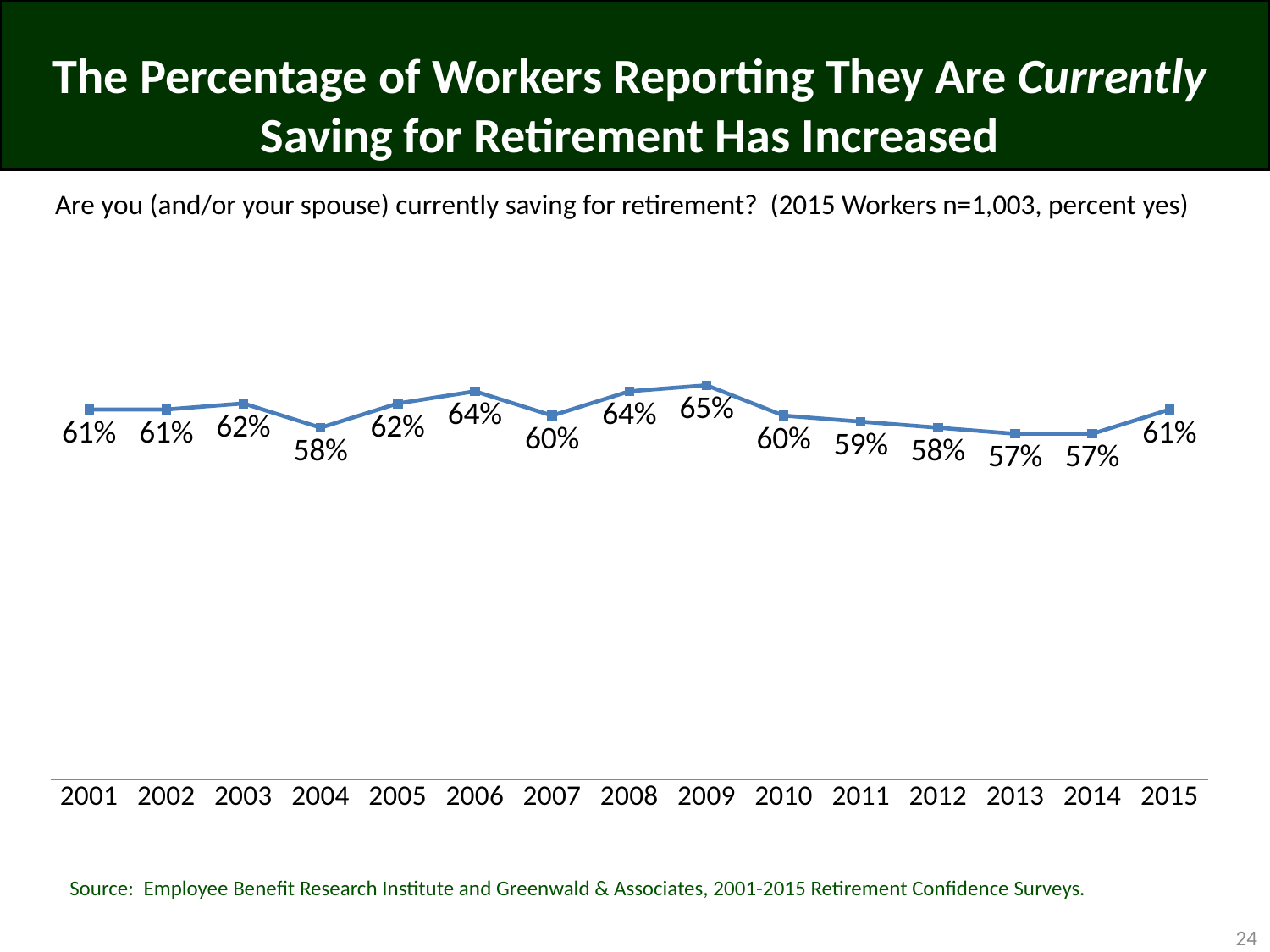
Which year has the highest percentage of workers currently saving for retirement? 2009 What is the difference between the 2009 value and the 2014 value? 8 percentage points What is the lowest value plotted on the chart? 57% What type of chart is shown on the slide? Line chart What percentage of workers reported currently saving for retirement in 2009? 65% What is the value shown for 2004? 58% Which year has the larger value, 2006 or 2012? 2006 How many years are plotted on the chart? 15 What is the difference between the 2015 value and the 2014 value? 4 percentage points What is the sample size of workers given for 2015 in the chart subtitle? n=1,003 What percentage is shown for 2015? 61% Did the percentage rise or fall from 2009 to 2014? Fall